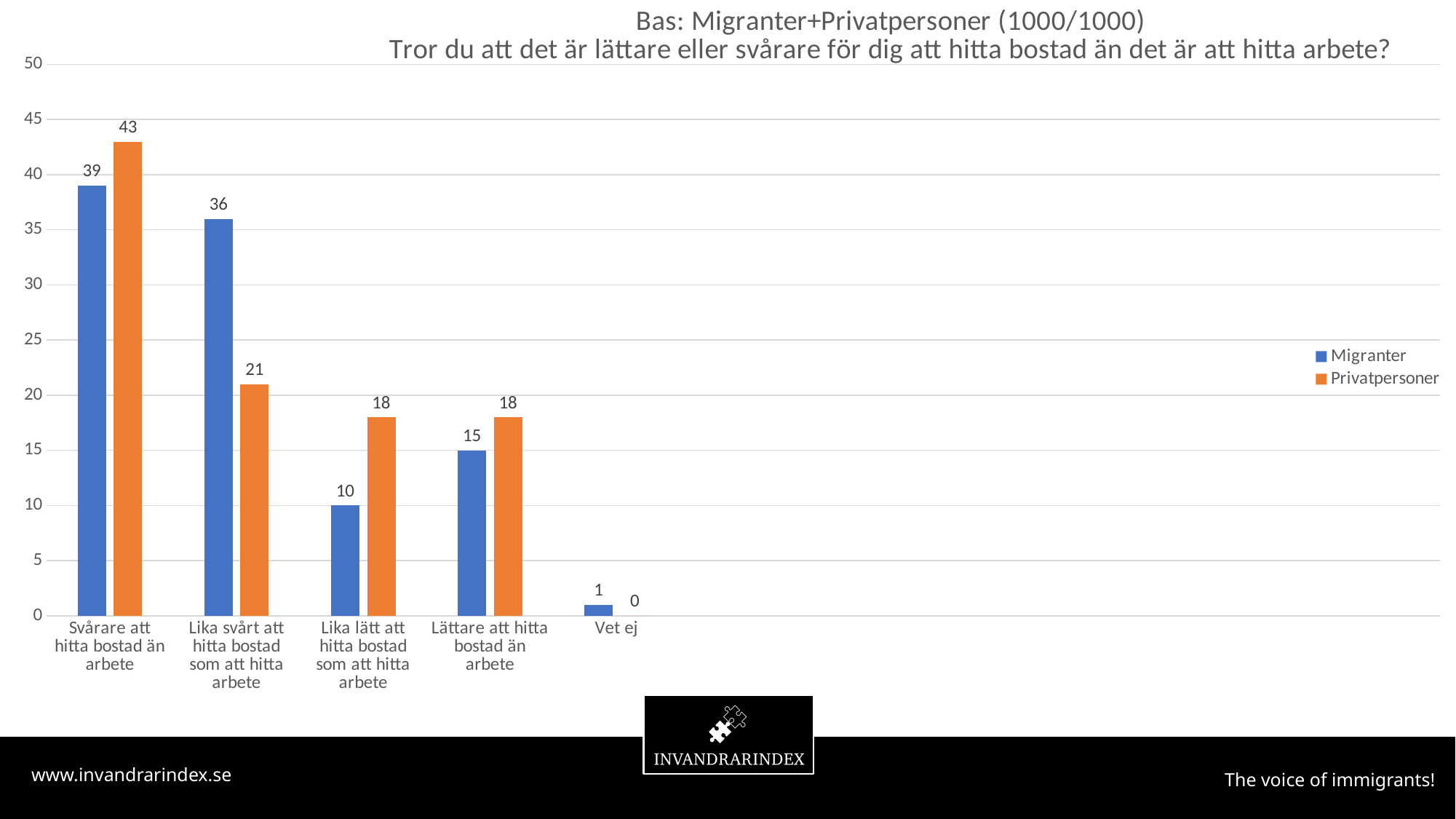
What is the value for Migranter in the category 'Vet ej'? 1 How many series does the legend list? 2 Which category has the lowest value for Migranter? Vet ej What is the value for Privatpersoner in the category 'Lika svårt att hitta bostad som att hitta arbete'? 21 What is the difference between the Privatpersoner and Migranter values in the category 'Lika svårt att hitta bostad som att hitta arbete'? 15 What is the value for Migranter in the category 'Svårare att hitta bostad än arbete'? 39 Which colour represents the Privatpersoner series? Orange In the category 'Lika lätt att hitta bostad som att hitta arbete', which series has the larger value, Migranter or Privatpersoner? Privatpersoner Is the value for Migranter in 'Lika svårt att hitta bostad som att hitta arbete' greater or less than 30? greater Which category has the highest value for Privatpersoner? Svårare att hitta bostad än arbete How many categories are shown on the x axis? 5 What kind of chart is shown on the slide? Bar chart